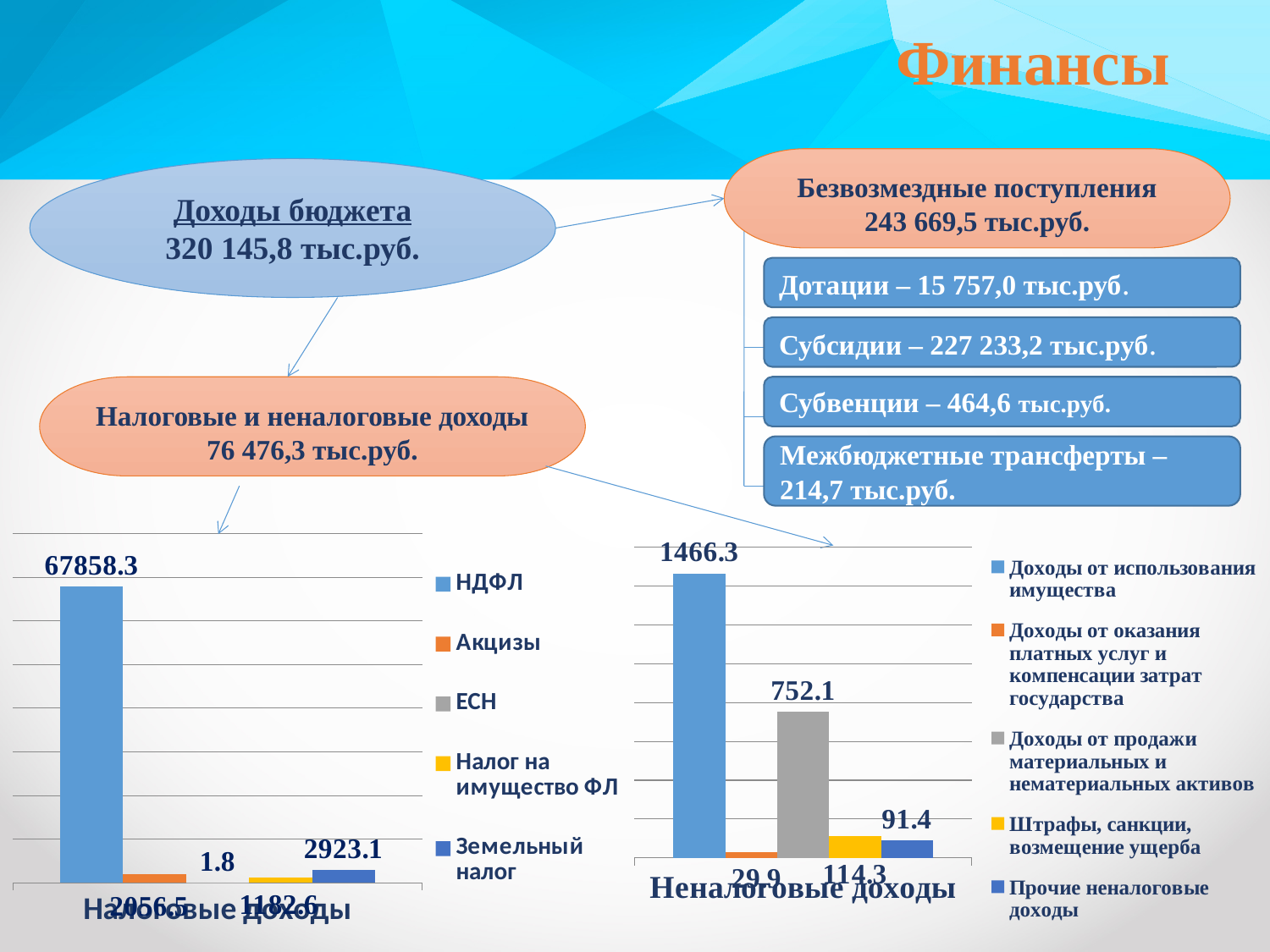
In the left chart 'Налоговые доходы', what is the value for НДФЛ? 67858.3 In the left chart 'Налоговые доходы', which series has the highest value? НДФЛ In the left chart 'Налоговые доходы', what is the value for Акцизы? 2056.5 What kind of chart is the left chart titled 'Налоговые доходы'? bar chart In the right chart 'Неналоговые доходы', what is the value for Доходы от использования имущества? 1466.3 In the left chart 'Налоговые доходы', what is the value for Земельный налог? 2923.1 In the right chart 'Неналоговые доходы', what is the difference between Доходы от использования имущества and Доходы от продажи материальных и нематериальных активов? 714.2 In the left chart 'Налоговые доходы', which series has the lowest value? ЕСН In the right chart 'Неналоговые доходы', which is larger: Штрафы, санкции, возмещение ущерба or Прочие неналоговые доходы? Штрафы, санкции, возмещение ущерба In the right chart 'Неналоговые доходы', which series has the highest value? Доходы от использования имущества How many series does the legend of the left chart 'Налоговые доходы' list? 5 In the right chart 'Неналоговые доходы', what is the value for Доходы от продажи материальных и нематериальных активов? 752.1